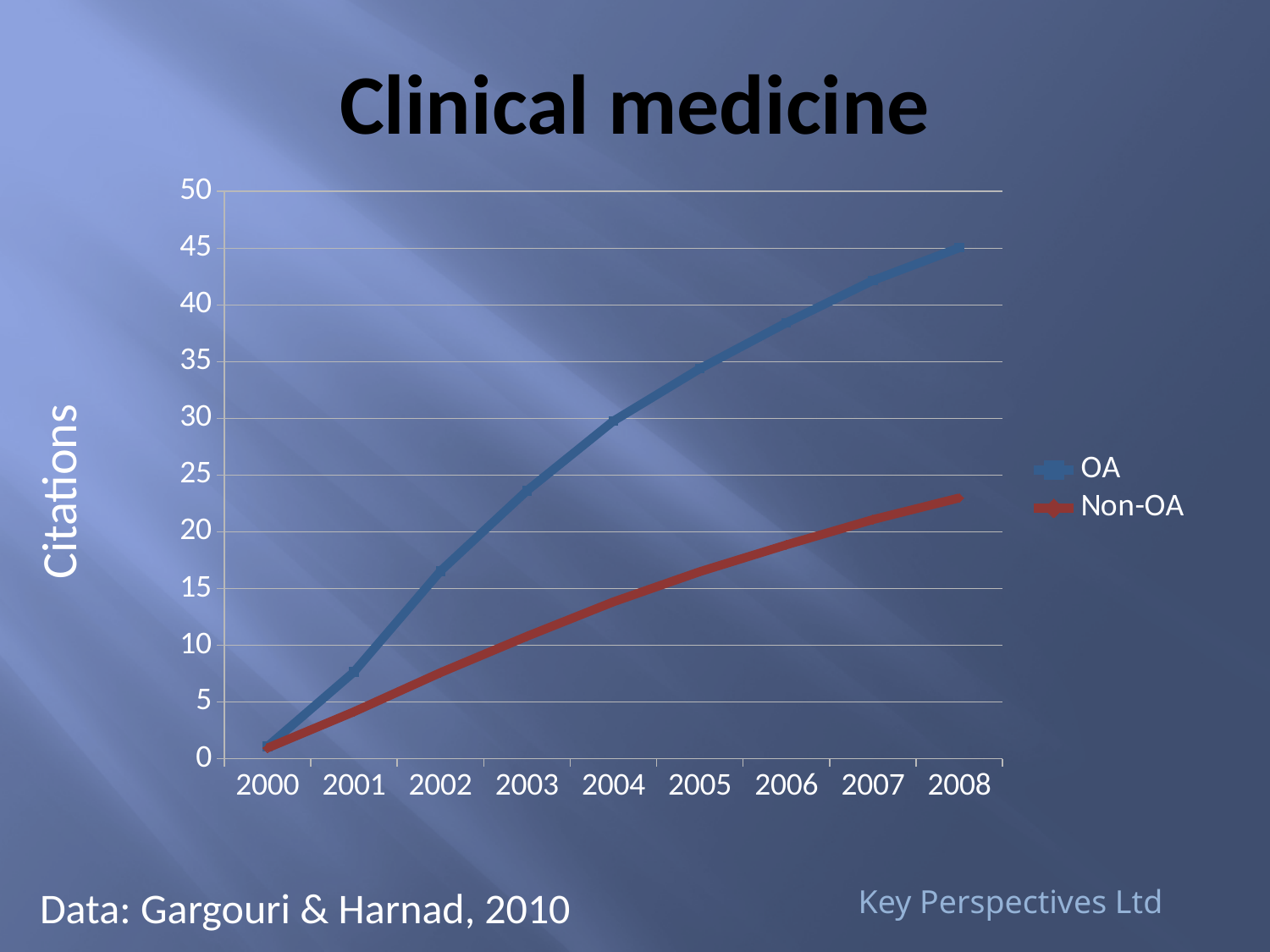
Is the OA value for 2002 greater or less than 10? greater How many series does the legend list? 2 Is the Non-OA value for 2008 greater or less than 25? less What kind of chart is shown on the slide? line chart In 2008, which series has more citations, OA or Non-OA? OA Is the OA value for 2004 greater or less than 20? greater What is the title of the chart? Clinical medicine In which year does the OA series reach its highest value? 2008 How many years are shown on the x axis? 9 Do the OA citations rise or fall from 2000 to 2008? rise What is the label on the y axis? Citations